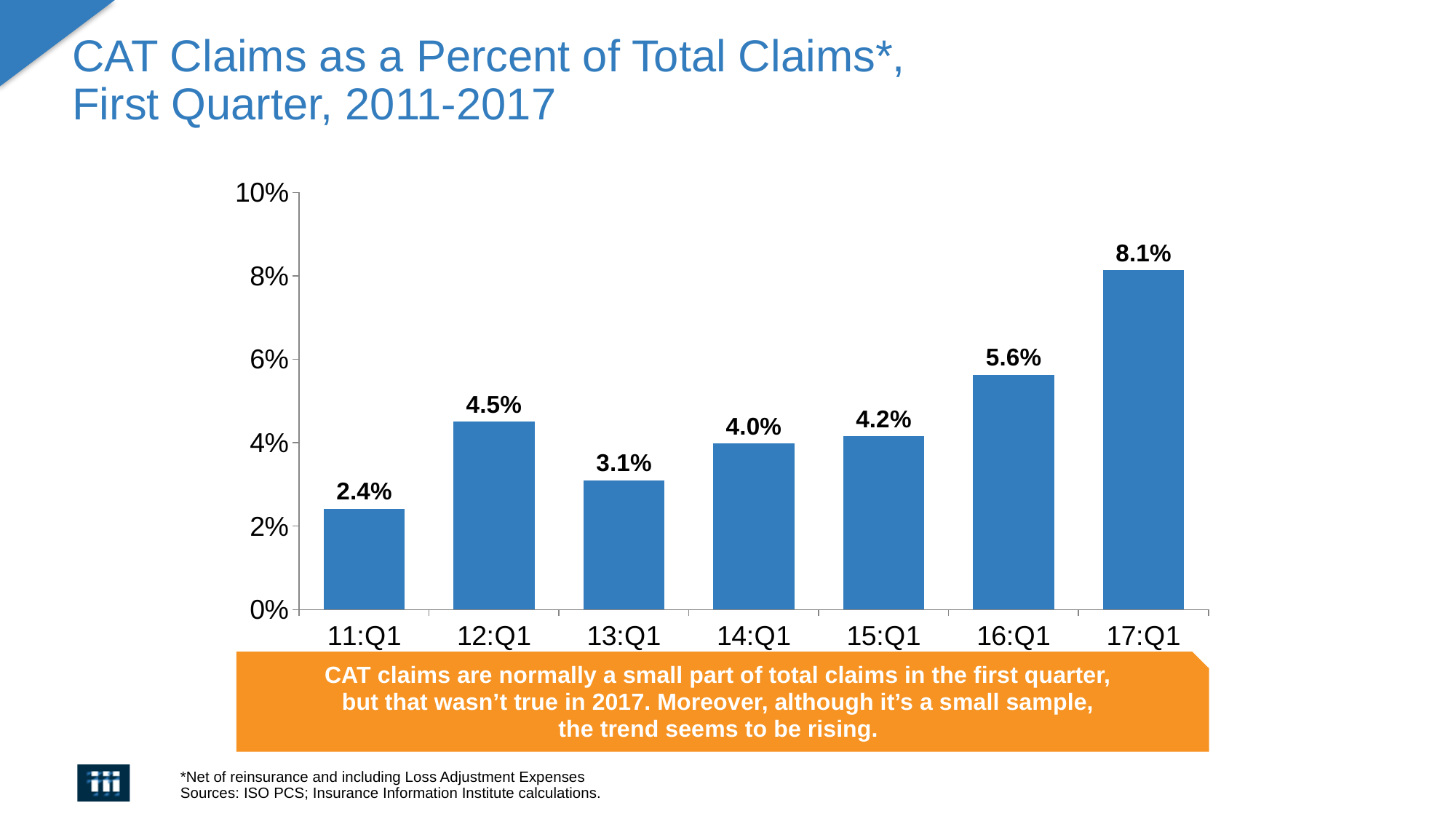
How many quarters are shown on the x axis? 7 Which quarter has the lowest value? 11:Q1 Which is larger, the value for 12:Q1 or the value for 15:Q1? 12:Q1 What is the difference between the values for 17:Q1 and 16:Q1? 2.5% Which quarter has the highest value? 17:Q1 What is the difference between the values for 12:Q1 and 13:Q1? 1.4% What kind of chart is shown on the slide? bar chart What is the value for 14:Q1? 4.0% What is the value for 16:Q1? 5.6% Is the value for 17:Q1 greater or less than 8%? greater What is the value for 11:Q1? 2.4% What is the title of the chart? CAT Claims as a Percent of Total Claims*, First Quarter, 2011-2017